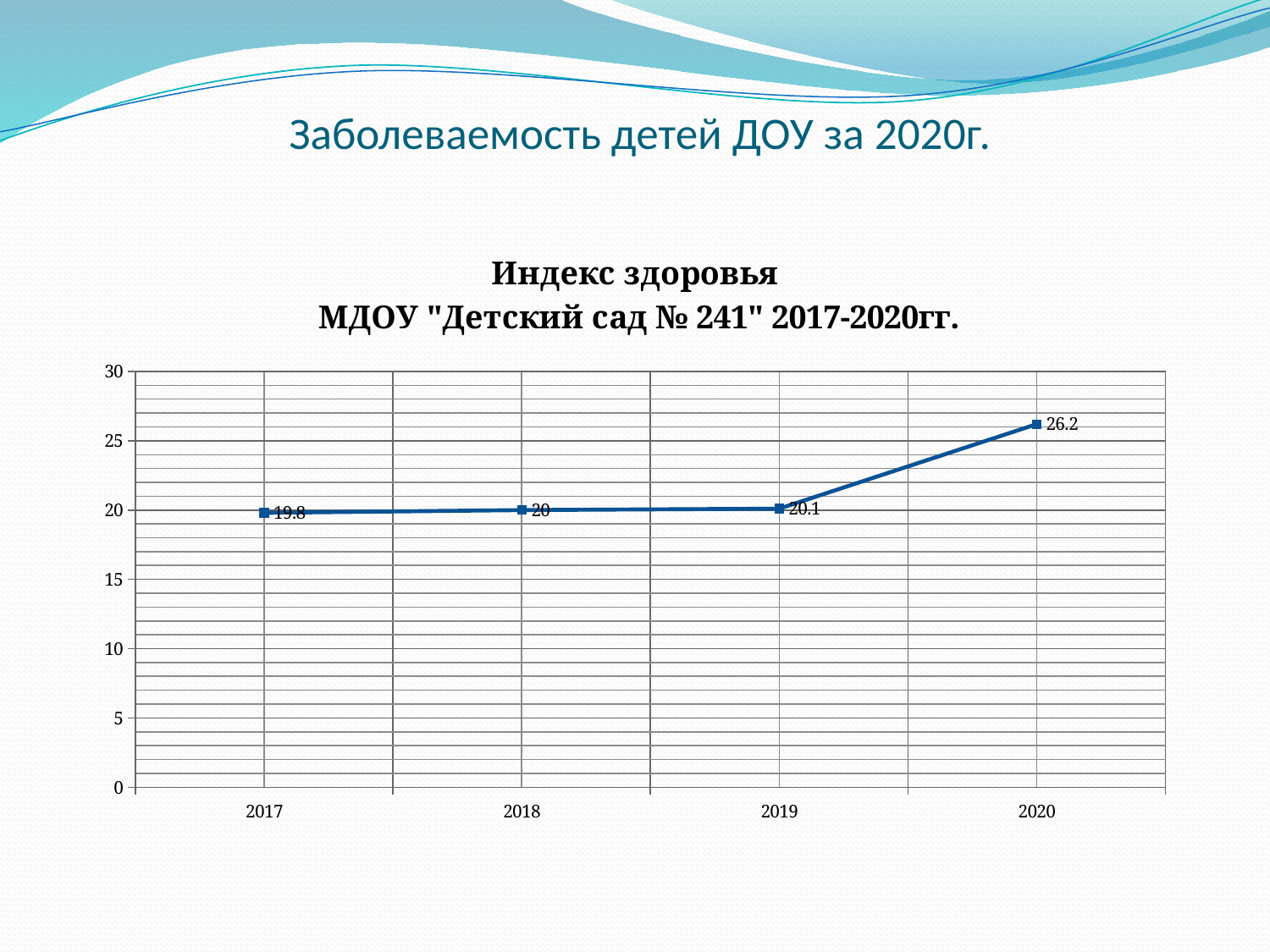
What is the maximum value shown on the vertical axis? 30 What kind of chart is shown on the slide? line chart Which year has a higher health index, 2018 or 2020? 2020 How many years are plotted on the chart? 4 Which year has the lowest health index? 2017 What is the health index value for 2020? 26.2 Is the value for 2020 greater or less than 25? greater What is the health index value for 2017? 19.8 Does the health index rise or fall from 2017 to 2020? rise What is the health index value for 2019? 20.1 Which year has the highest health index? 2020 What is the difference between the health index in 2020 and in 2019? 6.1